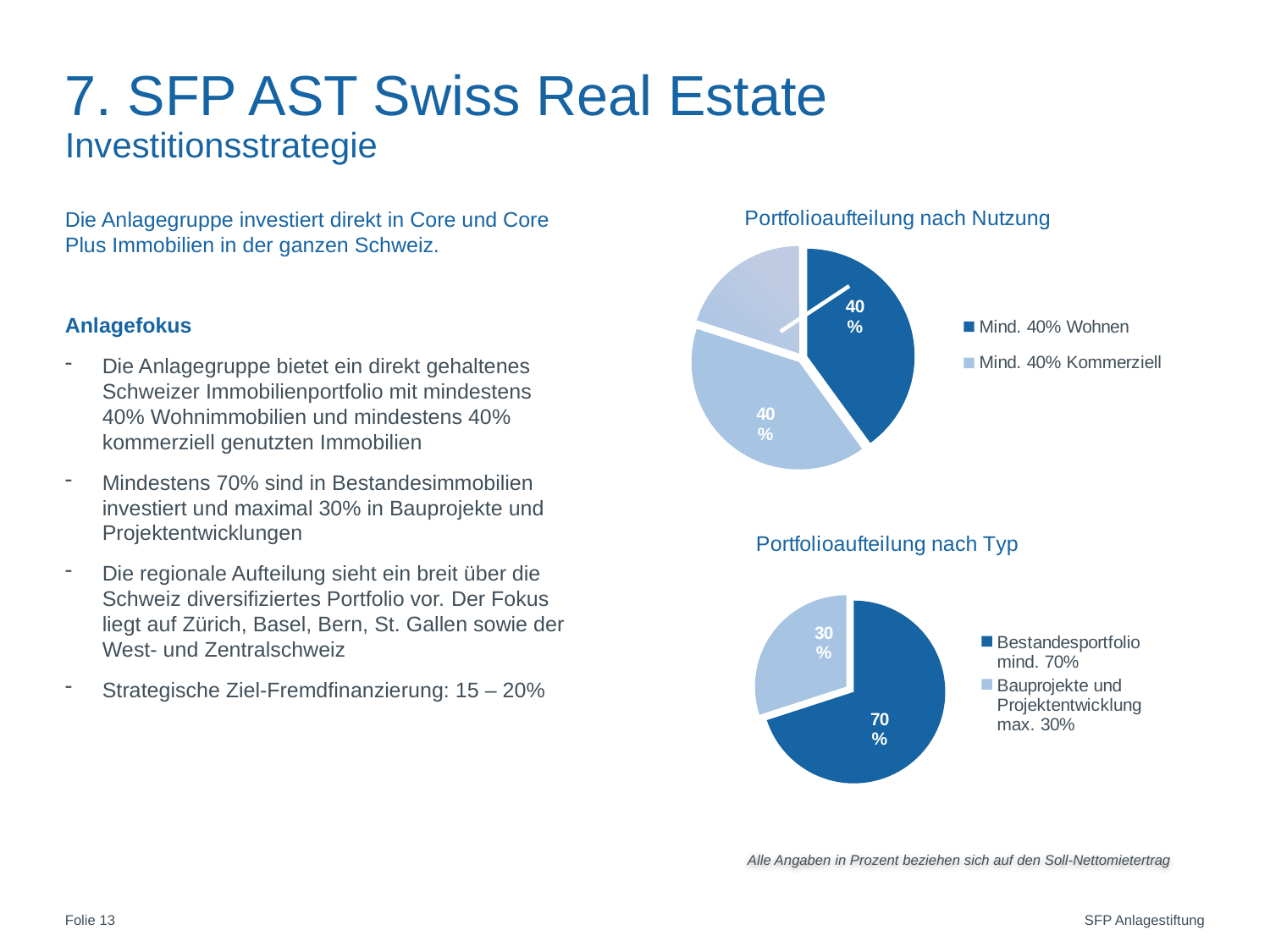
What kind of chart is the 'Portfolioaufteilung nach Nutzung' chart? pie chart In the 'Portfolioaufteilung nach Nutzung' chart, what value is shown for the 'Mind. 40% Wohnen' slice? 40% In the 'Portfolioaufteilung nach Nutzung' chart, what value is shown for the 'Mind. 40% Kommerziell' slice? 40% How many slices does the 'Portfolioaufteilung nach Typ' pie chart have? 2 What is the title of the upper chart on the slide? Portfolioaufteilung nach Nutzung How many entries does the legend of the 'Portfolioaufteilung nach Nutzung' chart list? 2 In the 'Portfolioaufteilung nach Typ' chart, what value is shown for 'Bestandesportfolio mind. 70%'? 70% In the 'Portfolioaufteilung nach Typ' chart, what is the difference between the 'Bestandesportfolio' slice and the 'Bauprojekte und Projektentwicklung' slice? 40% In the 'Portfolioaufteilung nach Typ' chart, which is larger: 'Bestandesportfolio' or 'Bauprojekte und Projektentwicklung'? Bestandesportfolio In the 'Portfolioaufteilung nach Typ' chart, which slice is the smallest? Bauprojekte und Projektentwicklung max. 30% In the 'Portfolioaufteilung nach Typ' chart, which slice is the largest? Bestandesportfolio mind. 70% In the 'Portfolioaufteilung nach Typ' chart, what share does 'Bauprojekte und Projektentwicklung max. 30%' have? 30%